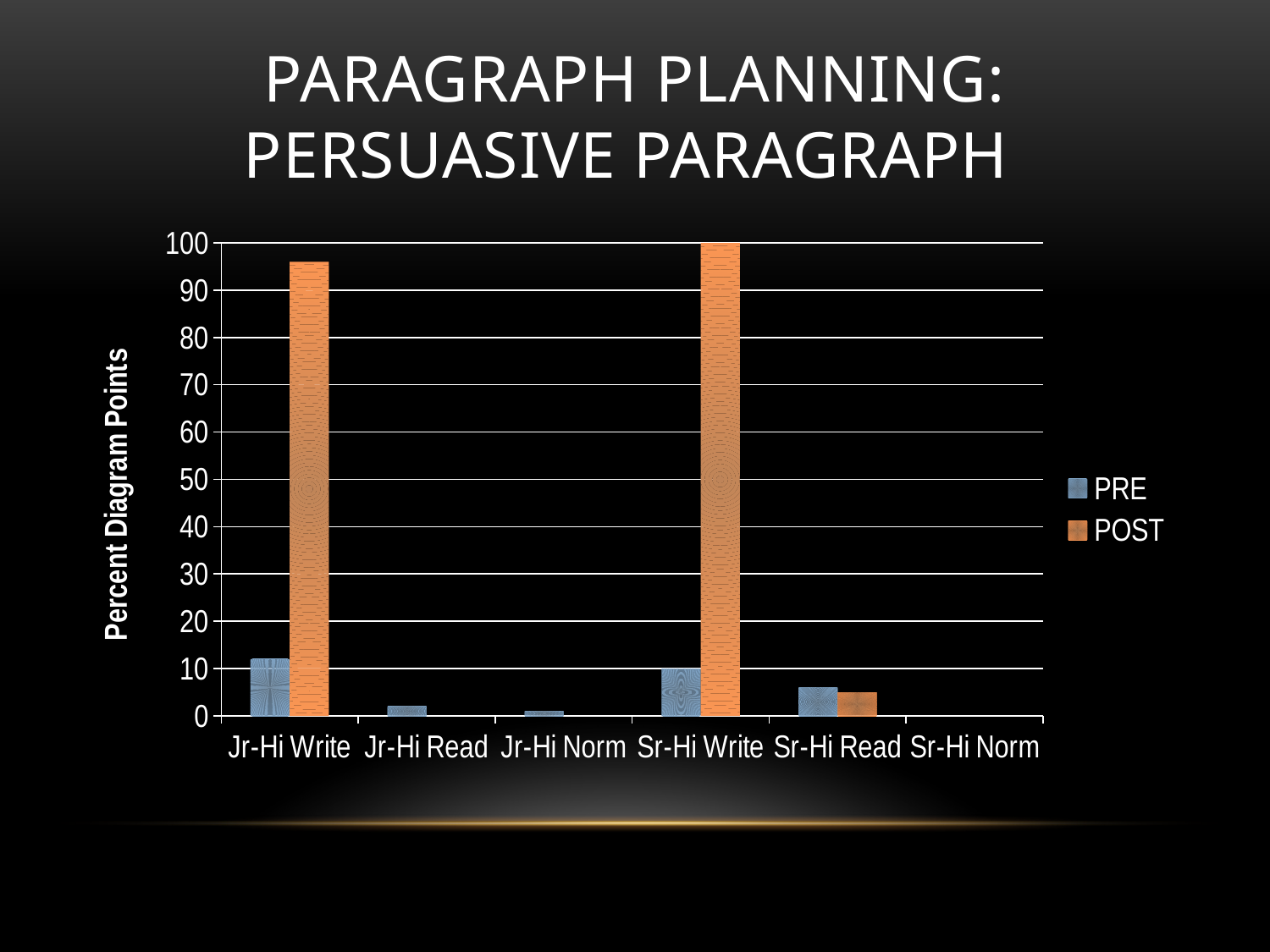
Is the PRE value for Sr-Hi Write greater or less than 20? less Is the PRE value for Jr-Hi Write greater or less than 20? less What is the title of the vertical axis? Percent Diagram Points Which category has the highest POST value? Sr-Hi Write Is the PRE value for Sr-Hi Read greater or less than 10? less How many categories are shown along the x axis? 6 Which series is shown in orange in the legend? POST Which category has the highest PRE value? Jr-Hi Write What kind of chart is shown on the slide? bar chart For Jr-Hi Write, which is larger, the PRE value or the POST value? POST How many series does the legend list? 2